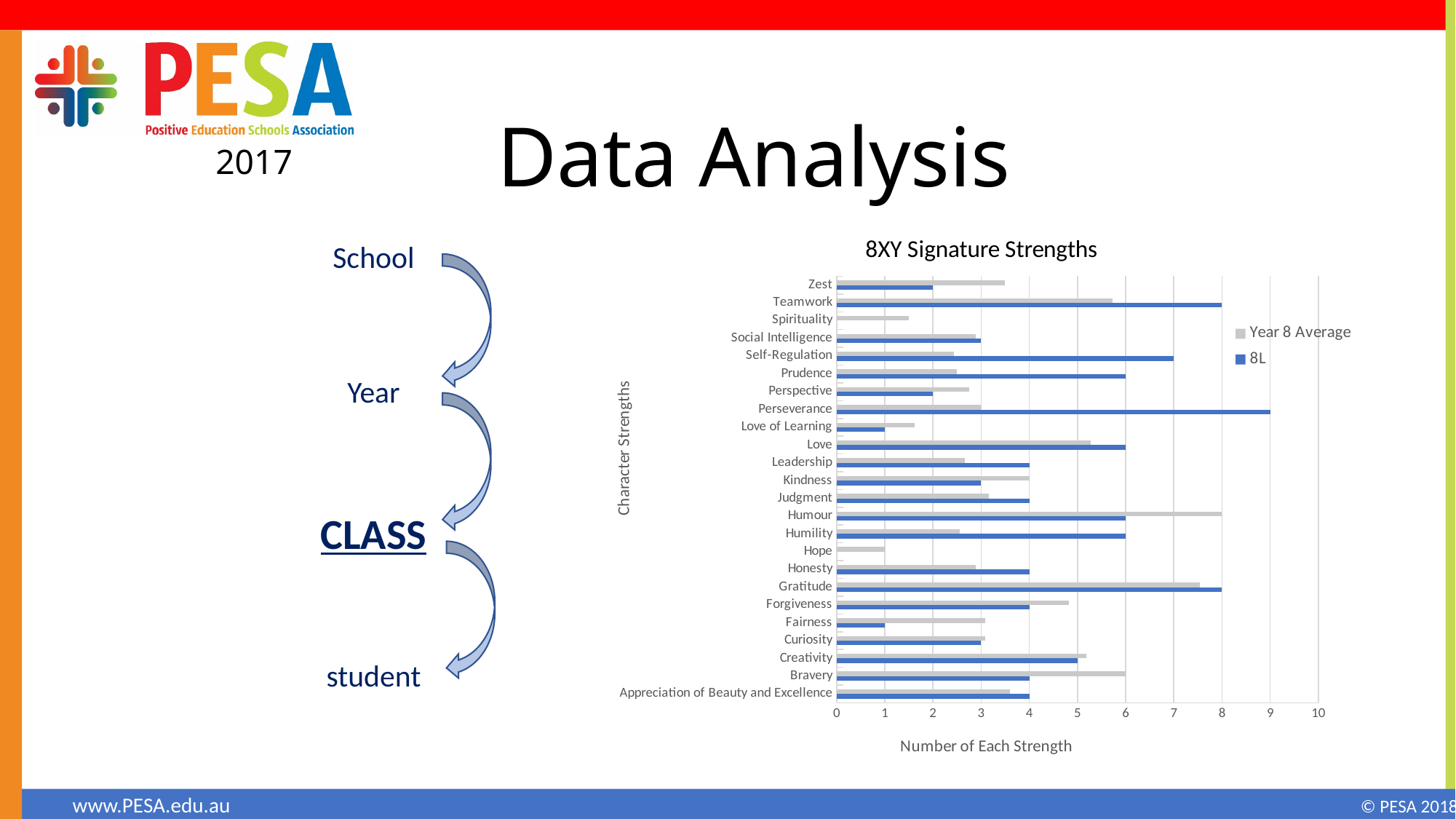
For Teamwork, which is larger: the 8L value or the Year 8 Average value? 8L What is the 8L value for Teamwork? 8 What kind of chart is shown on the slide? bar chart Is the 8L value for Love of Learning greater or less than 2? less How many character strengths are listed on the y axis of the chart? 24 What is the 8L value for Perseverance? 9 What is the title of the x axis of the chart? Number of Each Strength How many series does the legend of the 8XY Signature Strengths chart list? 2 Which character strength has the highest 8L value? Perseverance Is the Year 8 Average value for Humour greater or less than 7? greater Is the 8L value for Self-Regulation greater or less than 6? greater For Zest, which is larger: the 8L value or the Year 8 Average value? Year 8 Average